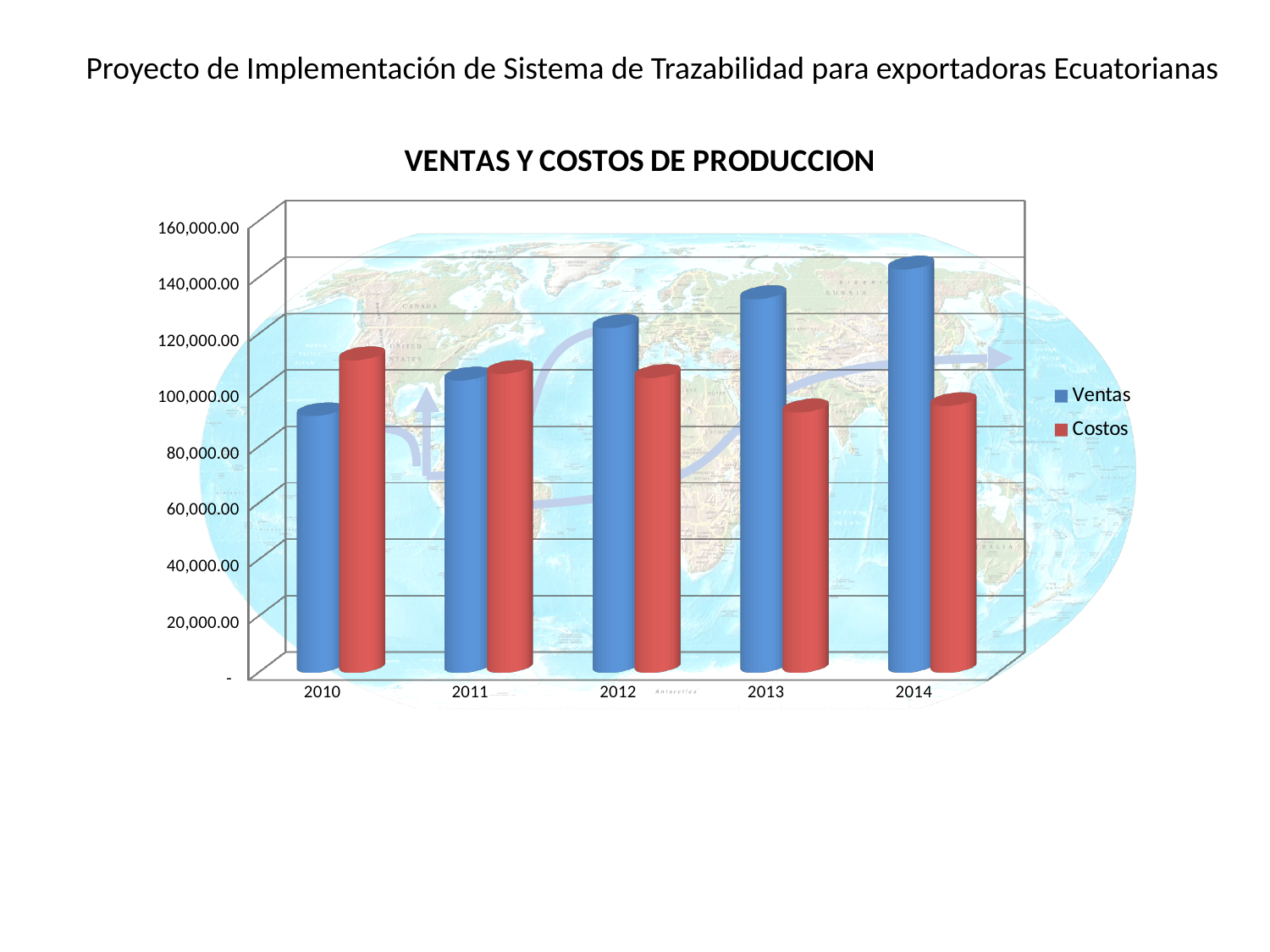
In 2014, which is larger, Ventas or Costos? Ventas Is the Ventas value for 2014 greater or less than 120,000.00? greater What is the title of the chart? VENTAS Y COSTOS DE PRODUCCION What kind of chart is shown on the slide? bar chart Is the Costos value for 2013 greater or less than 120,000.00? less How many series does the legend list? 2 Is the Ventas value for 2010 greater or less than 80,000.00? greater How many years are shown on the x axis? 5 Which year has the highest Ventas value? 2014 In 2010, which is larger, Ventas or Costos? Costos Which year has the lowest Ventas value? 2010 Do the Ventas values rise or fall from 2010 to 2014? rise